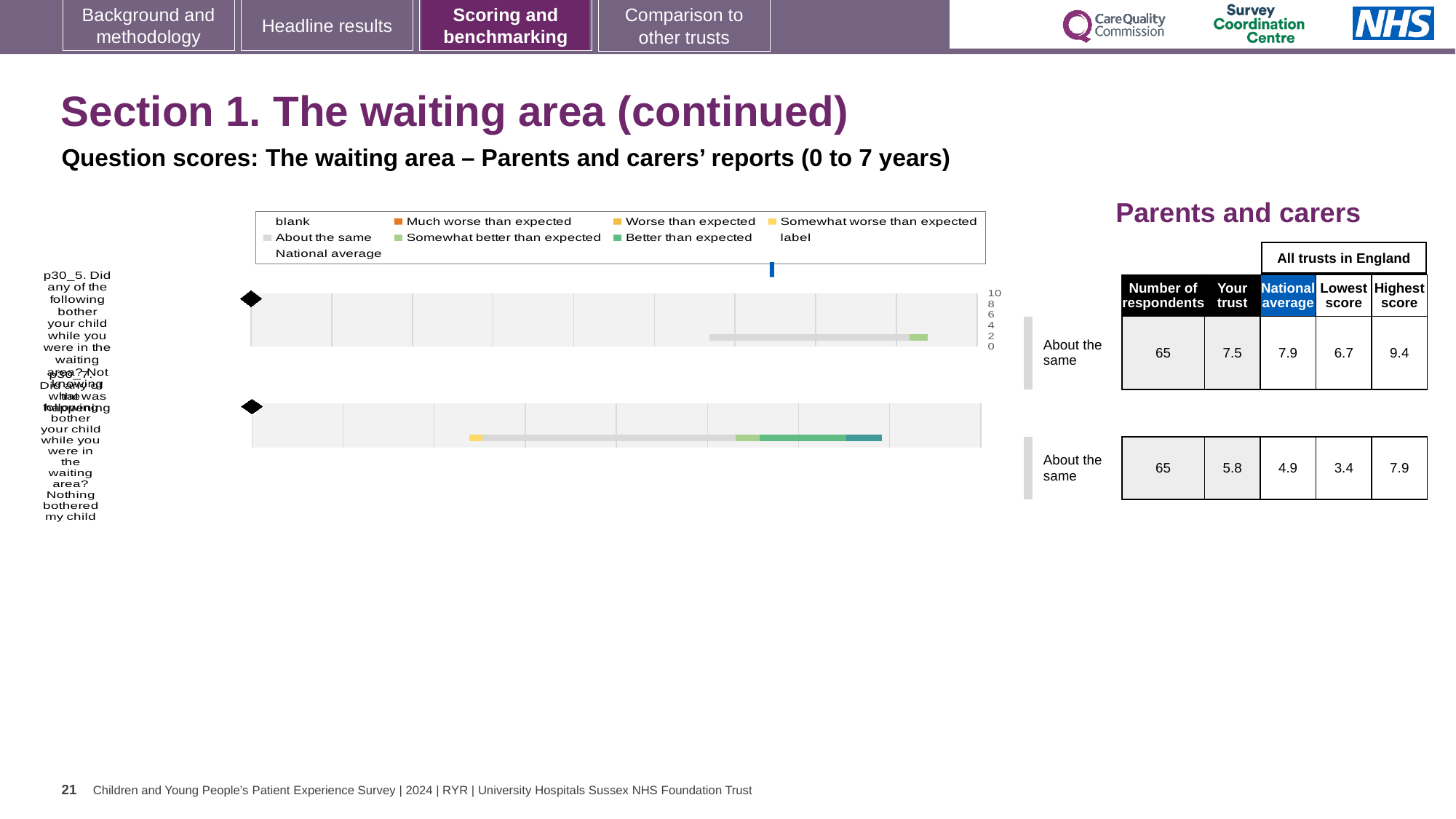
For the bottom chart (p30_7), what is the difference between the 'Your trust' score and the national average? 0.9 What benchmark category is shown next to both charts? About the same For the top chart (p30_5), which is larger: the 'Your trust' score or the national average? National average For the bottom chart (p30_7, Nothing bothered my child), what is the 'Your trust' score? 5.8 How many question charts are shown on the slide? 2 How many entries does the chart legend list? 9 For the top chart (p30_5), what is the difference between the highest score (9.4) and the lowest score (6.7)? 2.7 What kind of chart is used to show the question scores on this slide? bar chart For the top chart (p30_5), what is the national average score? 7.9 For the top chart (p30_5, Not knowing what was happening), what is the 'Your trust' score? 7.5 For the bottom chart (p30_7), what is the lowest score among all trusts in England? 3.4 For the bottom chart (p30_7), which is larger: the 'Your trust' score or the national average? Your trust